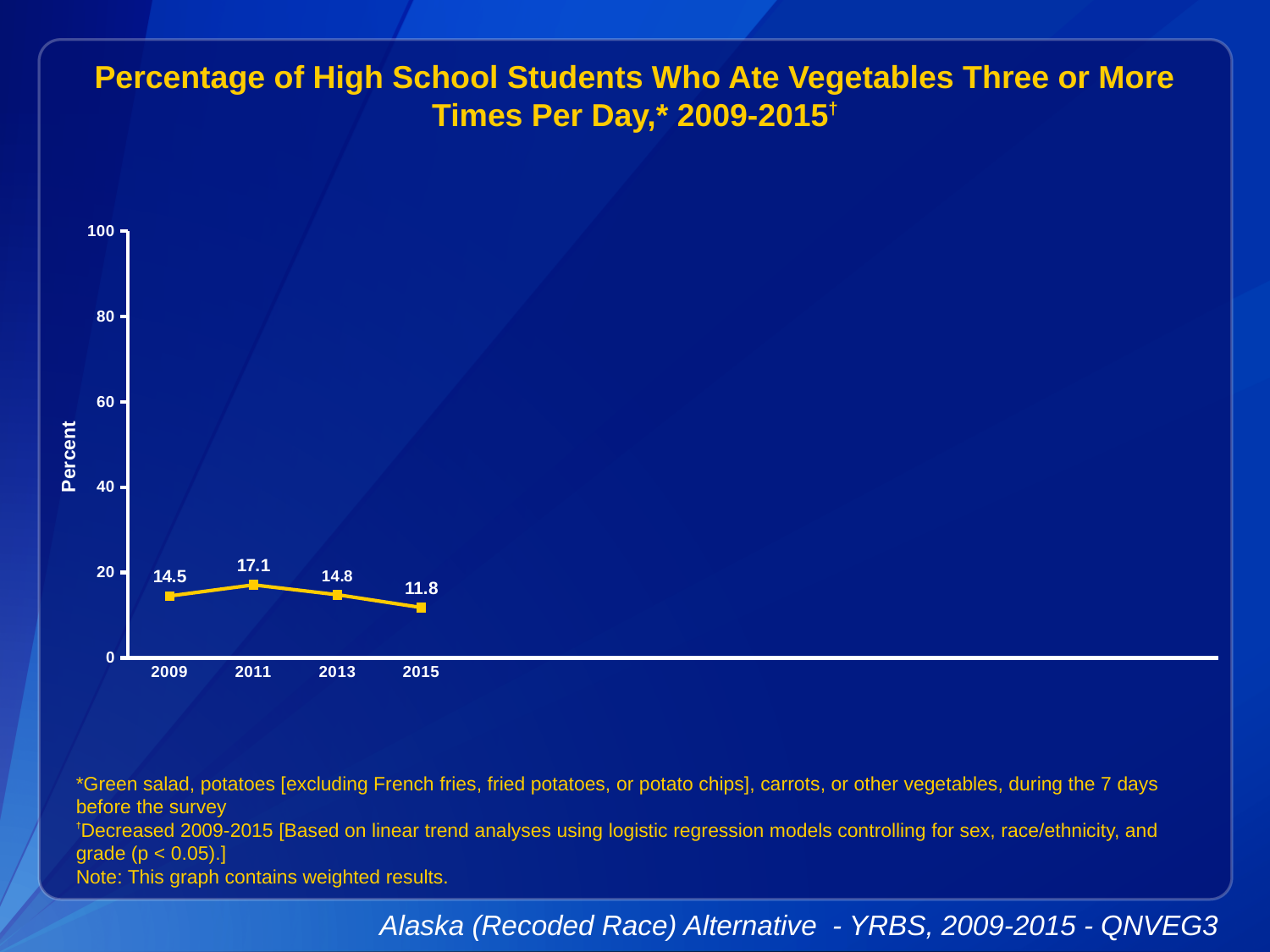
What is the value plotted for 2015? 11.8 Which year has the highest percentage? 2011 What is the label on the vertical axis? Percent What kind of chart is shown on the slide? line chart What is the difference between the 2011 value and the 2015 value? 5.3 What is the difference between the 2009 value and the 2013 value? 0.3 How many years are plotted on the chart? 4 What percentage of high school students ate vegetables three or more times per day in 2009? 14.5 Is the value for 2011 greater or less than 20? less What is the value plotted for 2011? 17.1 Which year has a larger value, 2009 or 2015? 2009 Which year has the lowest percentage? 2015